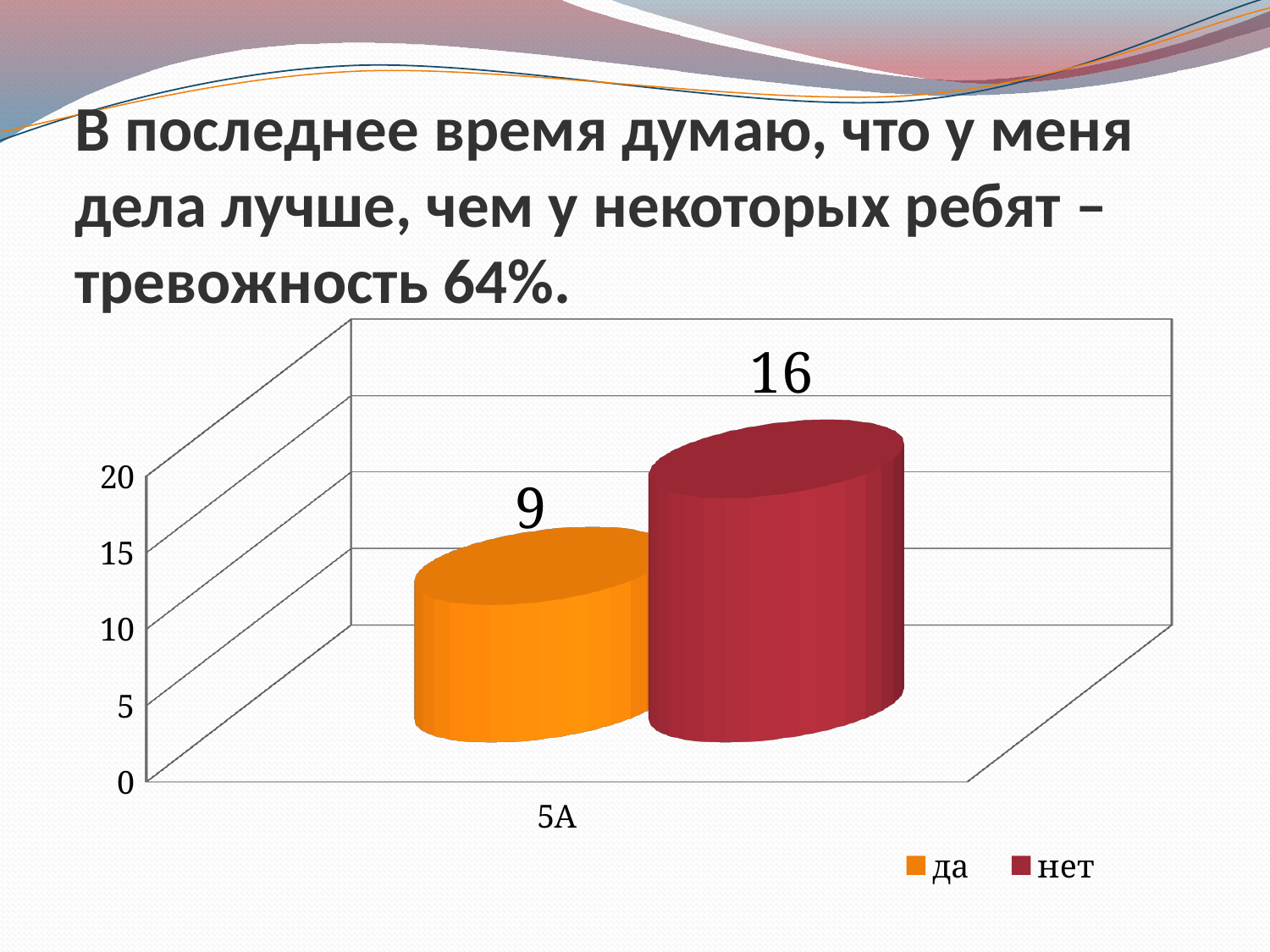
Is the value for "да" greater or less than 10? less What colour is the bar for the "нет" series? dark red How many categories are shown on the x axis? 1 What is the difference between the "нет" and "да" values for 5А? 7 Is the value for "нет" greater or less than 15? greater What is the value for "да" in category 5А? 9 What kind of chart is shown on the slide? bar chart What is the category label on the x axis? 5А What is the value for "нет" in category 5А? 16 Which series has the lowest value on the chart? да How many series does the legend list? 2 Which series has the higher value for 5А, "да" or "нет"? нет